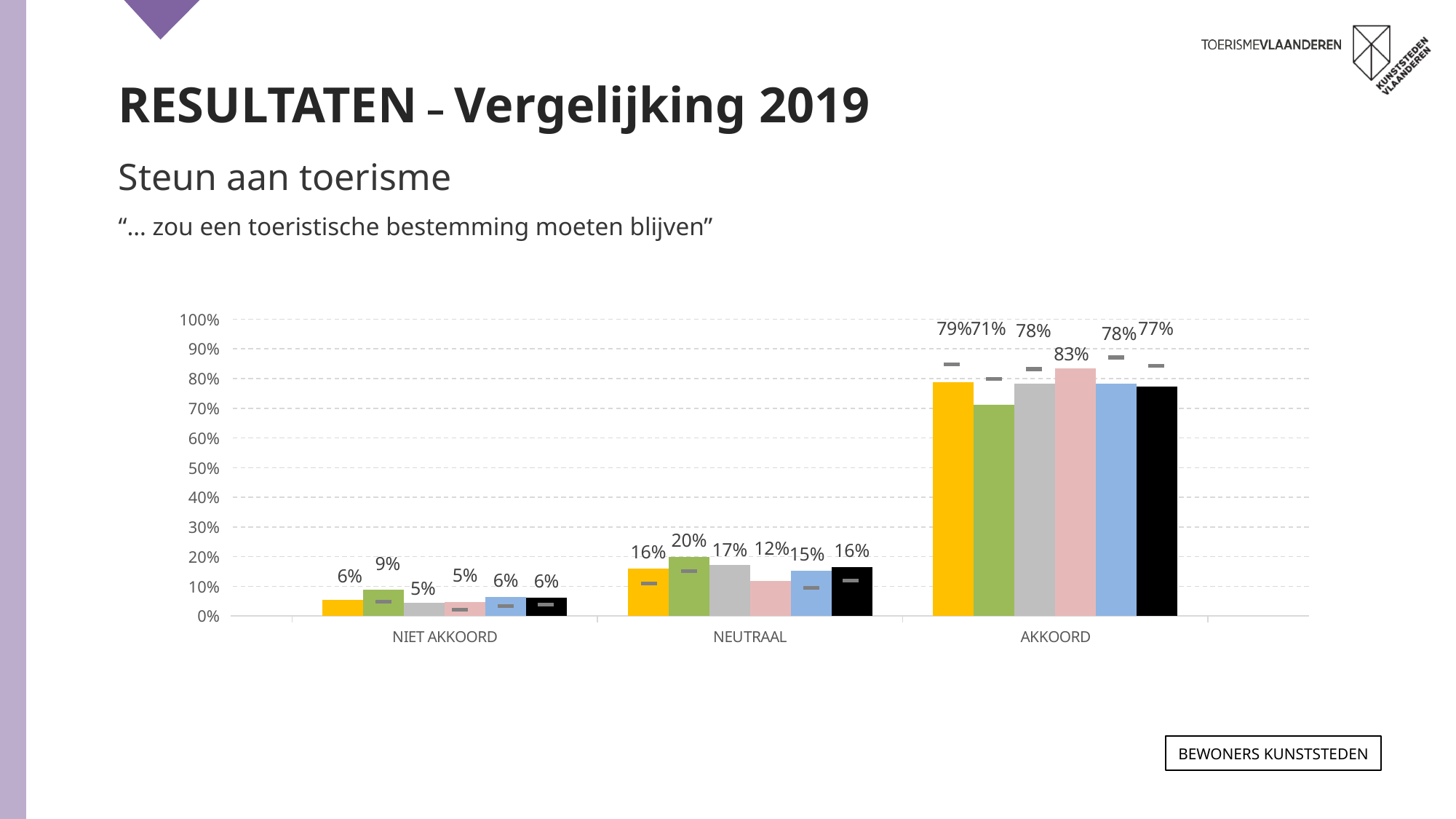
In the NIET AKKOORD category, which is larger: the green bar or the yellow bar? green bar How many bars are shown for each category on the x axis? 6 Which coloured bar is the lowest in the AKKOORD category? green (71%) What is the value of the yellow bar in the NIET AKKOORD category? 6% How many categories are shown on the x axis of the chart? 3 Is the value of the yellow bar in the AKKOORD category greater or less than 70%? greater What is the value of the pink bar in the AKKOORD category? 83% What is the difference between the pink bar (83%) and the green bar (71%) in the AKKOORD category? 12 percentage points Which coloured bar is the highest in the NEUTRAAL category? green (20%) What is the value of the green bar in the NEUTRAAL category? 20% What kind of chart is shown on the slide? bar chart Which coloured bar is the highest in the AKKOORD category? pink (83%)